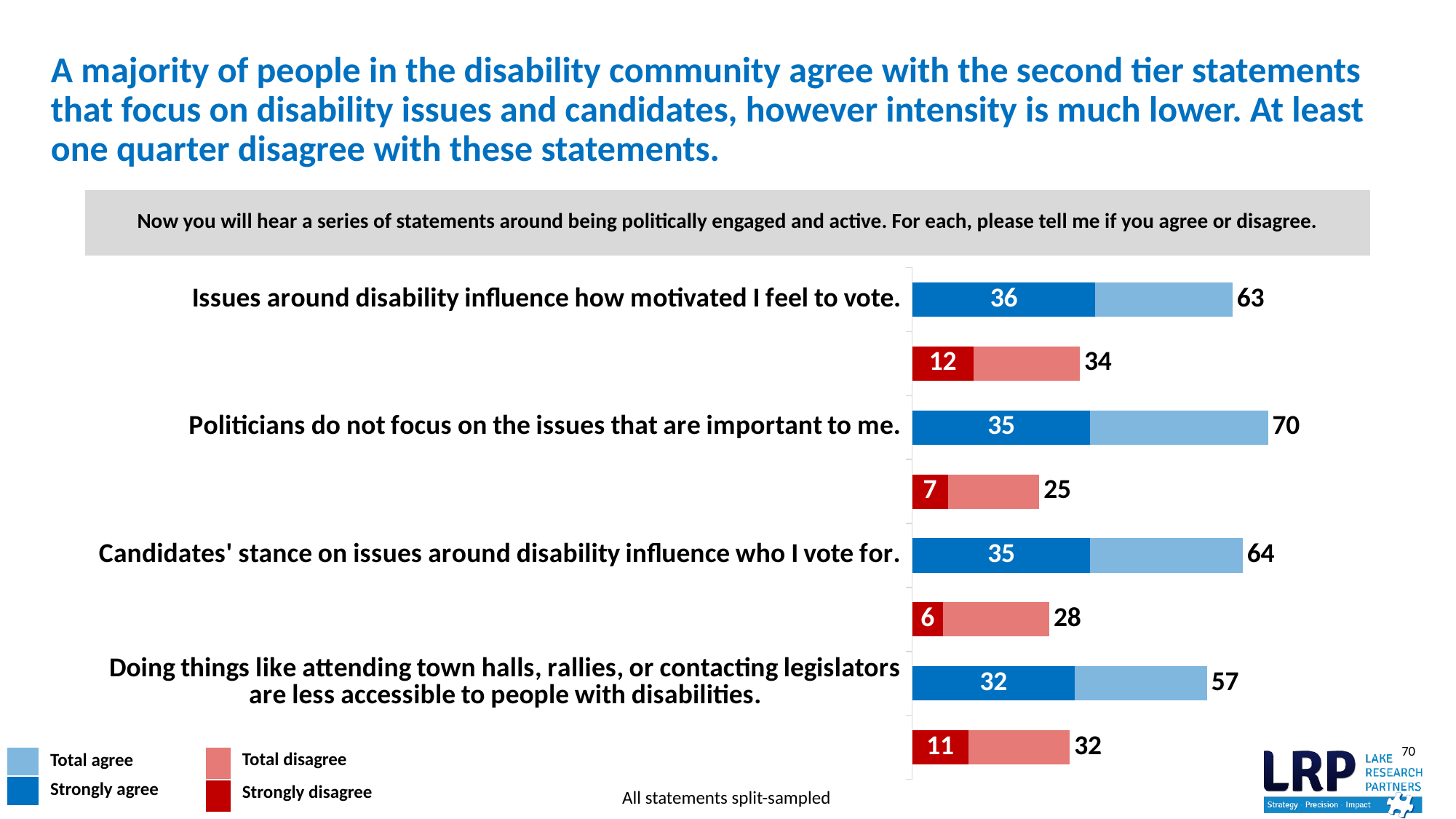
How many statements are shown in the chart? 4 What is the difference between the total agree and total disagree values for the statement "Politicians do not focus on the issues that are important to me"? 45 What is the strongly disagree value for the statement about attending town halls, rallies, or contacting legislators being less accessible to people with disabilities? 11 What is the total disagree value for the statement "Candidates' stance on issues around disability influence who I vote for"? 28 Which statement has the lowest total agree value? Doing things like attending town halls, rallies, or contacting legislators are less accessible to people with disabilities. Which statement has the lowest strongly disagree value? Candidates' stance on issues around disability influence who I vote for. What is the total agree value for the statement "Politicians do not focus on the issues that are important to me"? 70 Which is larger: the total disagree value for "Issues around disability influence how motivated I feel to vote" or the total disagree value for the statement about attending town halls being less accessible? Issues around disability influence how motivated I feel to vote (34) What kind of chart is shown on the slide? Bar chart How many series does the legend list? 4 Which statement has the highest total agree value? Politicians do not focus on the issues that are important to me. What is the strongly agree value for the statement "Issues around disability influence how motivated I feel to vote"? 36